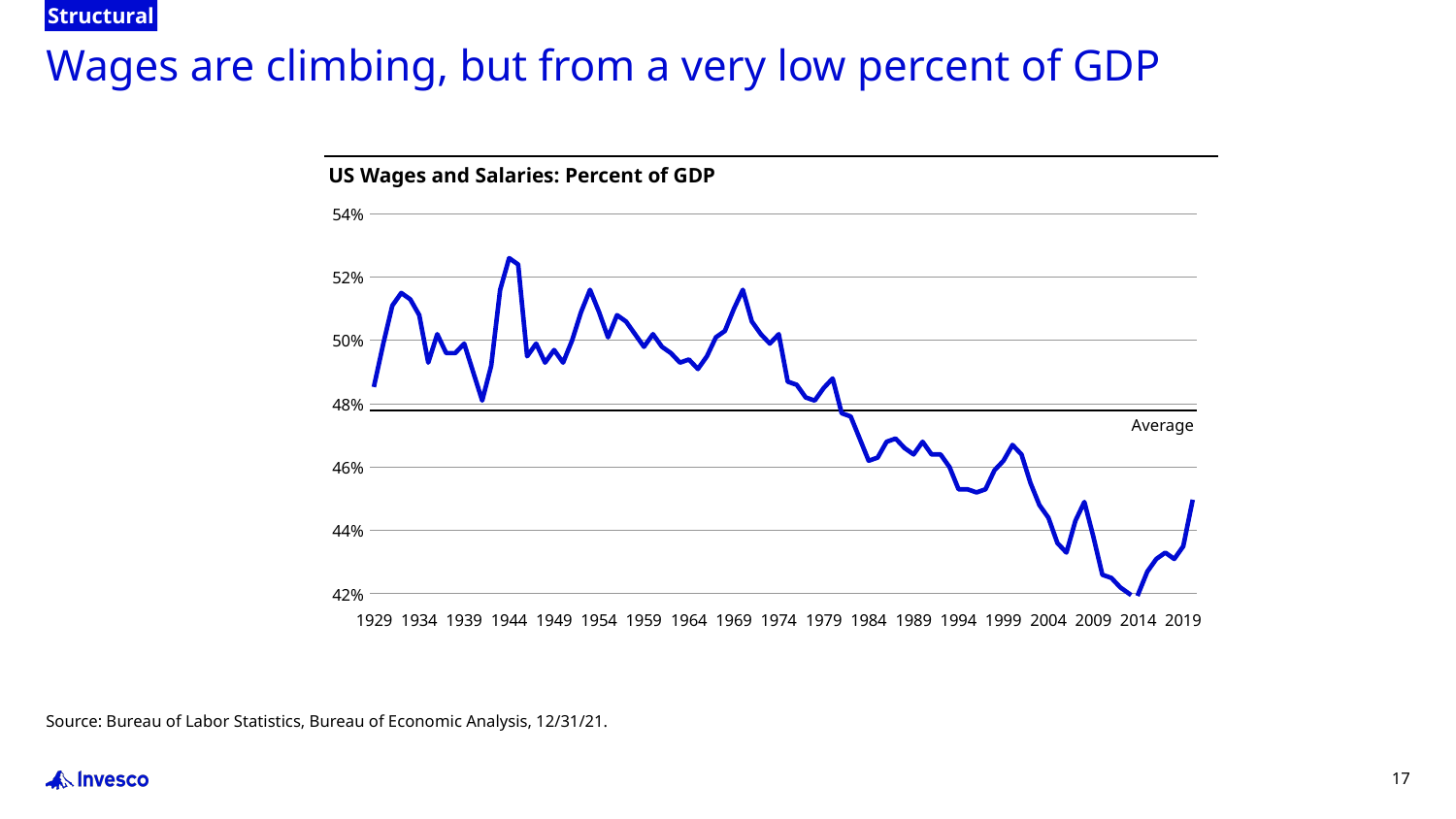
Is the value for 1969 greater or less than 50%? greater What does the horizontal black line across the chart represent? Average What is the title of the chart? US Wages and Salaries: Percent of GDP How many year labels are shown on the x axis? 19 What kind of chart is shown on the slide? Line chart Is the value for 1944 greater or less than 52%? greater Around which year label does the line reach its lowest value? 2014 Around which year label does the line reach its highest value? 1944 Is the value for 1984 greater or less than 48%? less Overall, does the line rise or fall from 1929 to 2019? Fall Which year has the larger value, 1944 or 2014? 1944